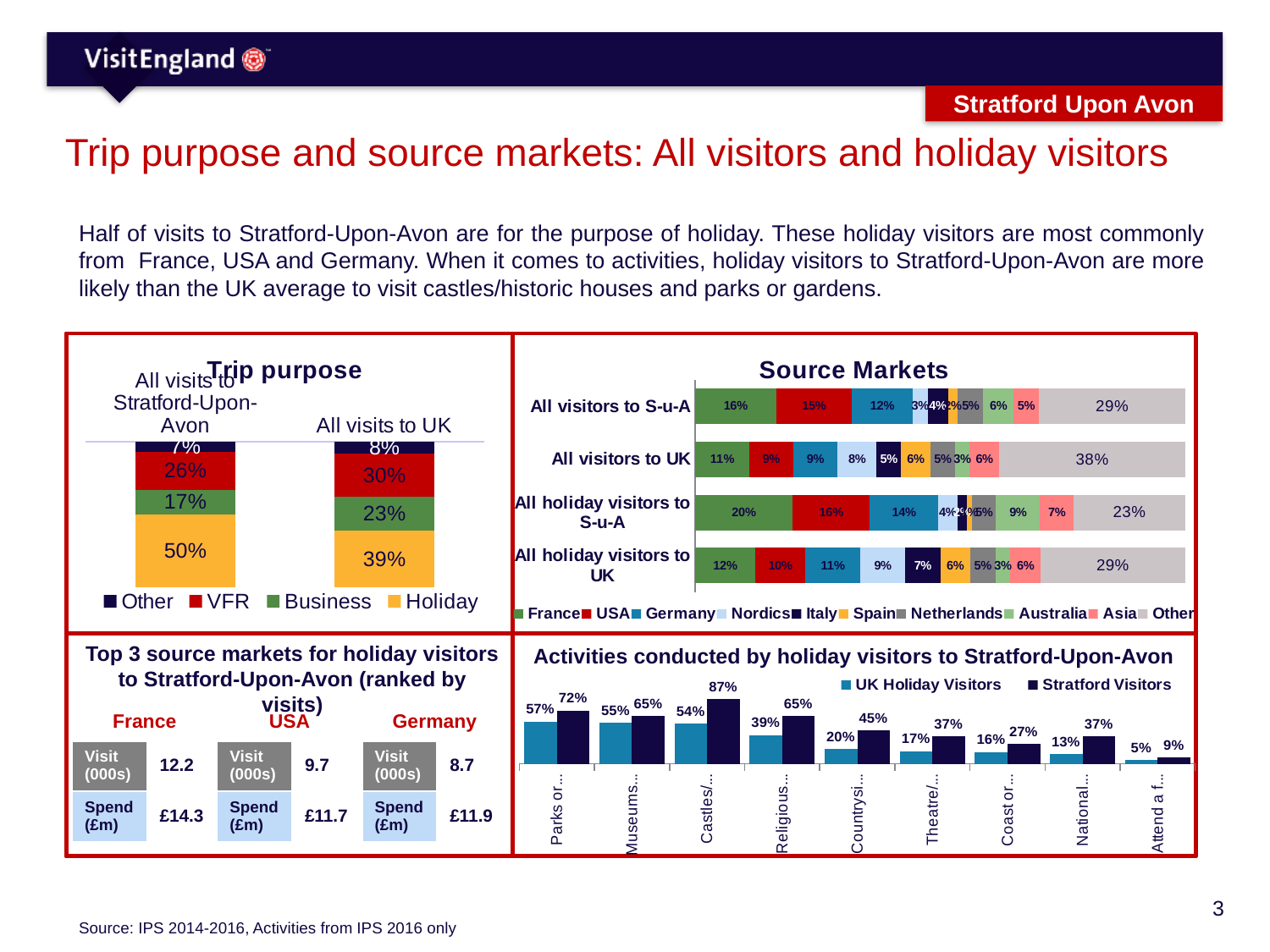
In the Activities chart, what is the difference between Stratford Visitors and UK Holiday Visitors for Countryside? 25% In the Activities chart, which activity has the highest value for Stratford Visitors? Castles How many series does the legend of the Trip purpose chart list? 4 In the Activities chart, what percentage of Stratford Visitors visited Castles? 87% In the Source Markets chart, what share of all holiday visitors to S-u-A come from France? 20% In the Trip purpose chart, what share of all visits to UK are for Business? 23% In the Source Markets chart, what is the Other share for all visitors to UK? 38% What kind of chart is the Source Markets chart? Stacked bar chart In the Activities chart, how many activity categories are shown? 9 In the Trip purpose chart, what share of all visits to Stratford-Upon-Avon are for Holiday? 50% In the Trip purpose chart, what is the difference between the VFR share for all visits to UK and for all visits to Stratford-Upon-Avon? 4% How many series does the legend of the Source Markets chart list? 10